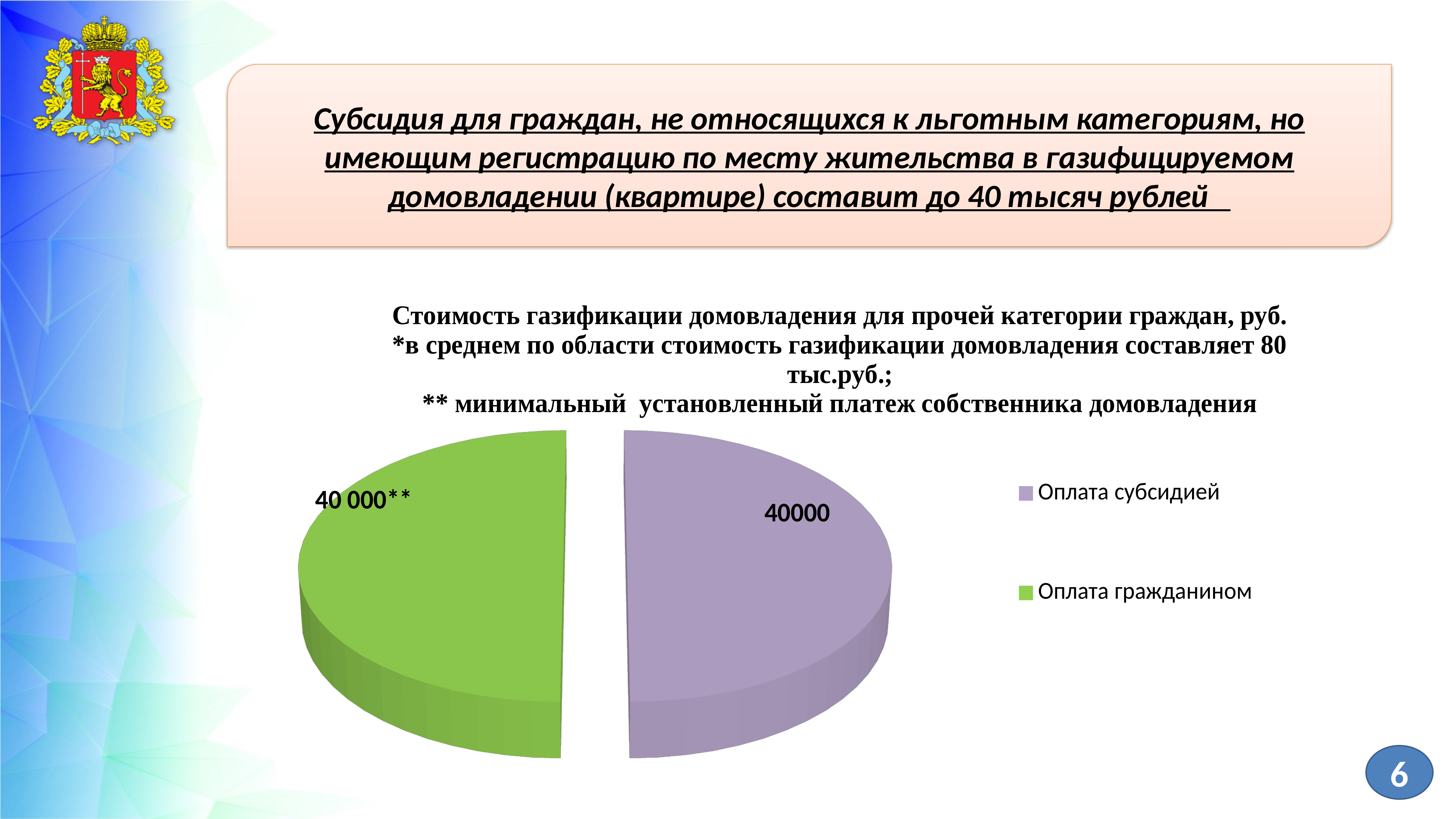
What value is shown for the "Оплата гражданином" slice? 40 000** What value is shown for the "Оплата субсидией" slice? 40000 Which colour represents "Оплата гражданином" in the pie chart? green What kind of chart is shown on the slide? pie chart What is the difference between the "Оплата субсидией" and "Оплата гражданином" values? 0 Which colour represents "Оплата субсидией" in the pie chart? purple What share of the pie does the "Оплата гражданином" slice represent? 50% What is the total of the two slices in the pie chart? 80000 How many slices does the pie chart have? 2 What share of the pie does the "Оплата субсидией" slice represent? 50% How many entries does the legend of the pie chart list? 2